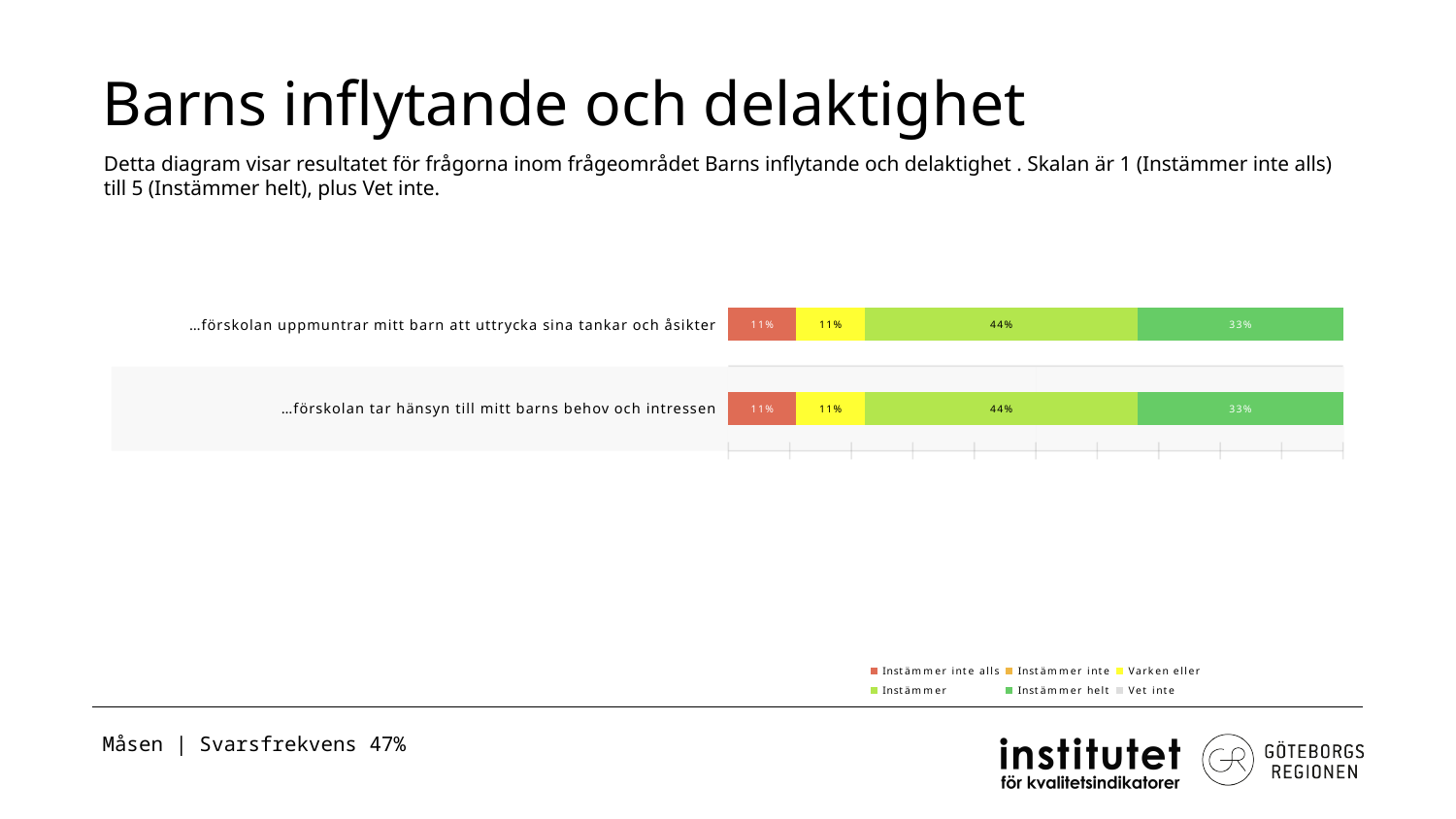
How many series does the legend list? 6 What is the value of the 'Instämmer helt' (dark green) segment for '…förskolan tar hänsyn till mitt barns behov och intressen'? 33% What is the total of the labelled segments in the bar for '…förskolan tar hänsyn till mitt barns behov och intressen'? 99% How many categories (questions) are plotted in the chart? 2 What is the value of the 'Varken eller' (yellow) segment for '…förskolan uppmuntrar mitt barn att uttrycka sina tankar och åsikter'? 11% Which segment is the largest in the bar for '…förskolan uppmuntrar mitt barn att uttrycka sina tankar och åsikter'? Instämmer (44%) What is the value of the 'Instämmer' (light green) segment for '…förskolan uppmuntrar mitt barn att uttrycka sina tankar och åsikter'? 44% Which legend entry is shown in red? Instämmer inte alls What is the difference between the 'Instämmer' and 'Instämmer helt' segments for '…förskolan tar hänsyn till mitt barns behov och intressen'? 11% What is the value of the 'Instämmer inte alls' (red) segment for '…förskolan tar hänsyn till mitt barns behov och intressen'? 11% Which is larger for '…förskolan uppmuntrar mitt barn att uttrycka sina tankar och åsikter': the 'Instämmer helt' segment or the 'Instämmer inte alls' segment? Instämmer helt What kind of chart is shown on the slide? stacked bar chart